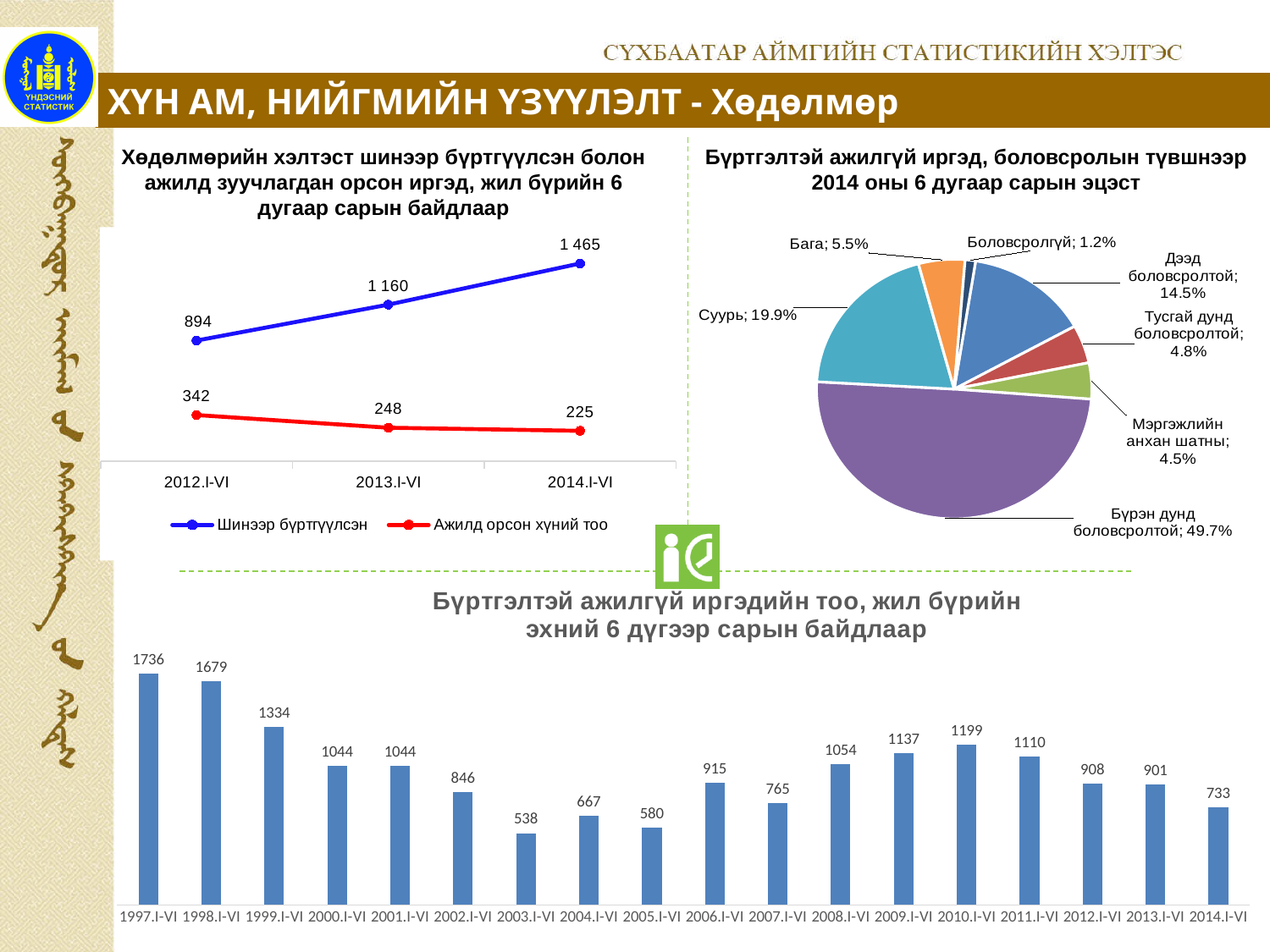
In the bottom bar chart (Бүртгэлтэй ажилгүй иргэдийн тоо), what is the difference between the values for 2010.I-VI and 2014.I-VI? 466 What kind of chart is the bottom chart (Бүртгэлтэй ажилгүй иргэдийн тоо)? bar chart In the bottom bar chart (Бүртгэлтэй ажилгүй иргэдийн тоо), which period has the lowest value? 2003.I-VI In the top-left line chart, what is the value of Ажилд орсон хүний тоо for 2012.I-VI? 342 In the top-left line chart, how many series does the legend list? 2 In the bottom bar chart (Бүртгэлтэй ажилгүй иргэдийн тоо), how many periods are shown on the x axis? 18 In the bottom bar chart (Бүртгэлтэй ажилгүй иргэдийн тоо), what is the value for 2003.I-VI? 538 In the top-left line chart, does the Шинээр бүртгүүлсэн series rise or fall from 2012.I-VI to 2014.I-VI? rise In the bottom bar chart (Бүртгэлтэй ажилгүй иргэдийн тоо), which period has the highest value? 1997.I-VI In the top-right pie chart, which slice is the smallest? Боловсролгүй In the top-left line chart, what is the value of Шинээр бүртгүүлсэн for 2014.I-VI? 1 465 In the top-right pie chart, what share does Бүрэн дунд боловсролтой have? 49.7%